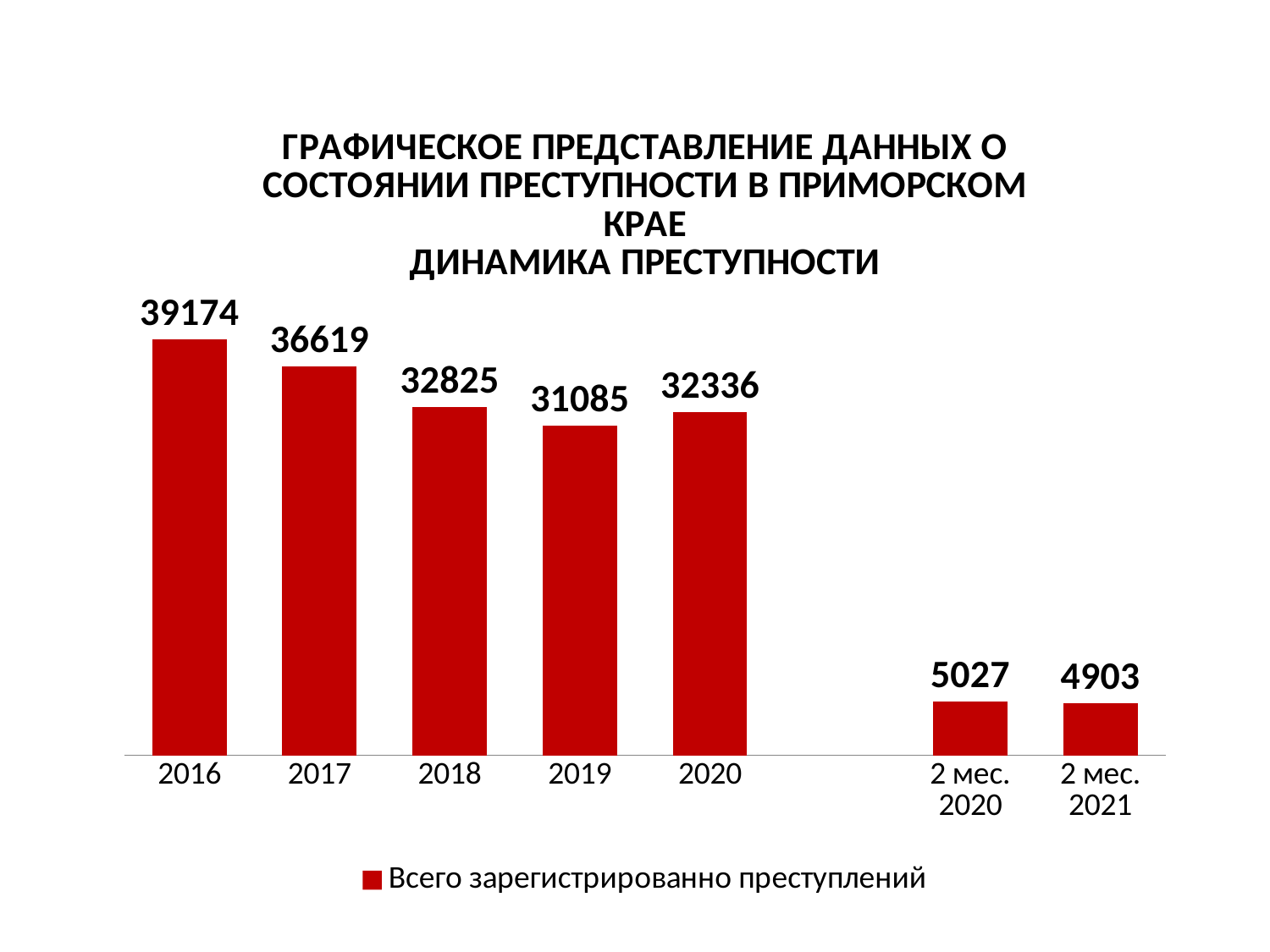
Do the values rise or fall from 2016 to 2019? fall What is the value for 2016? 39174 How many categories are shown on the x axis? 7 How many series does the legend list? 1 What is the difference between the values for 2 мес. 2020 and 2 мес. 2021? 124 Which category has the lowest value? 2 мес. 2021 What is the difference between the values for 2016 and 2017? 2555 What is the value for 2019? 31085 Which category has the highest value? 2016 What kind of chart is this? bar chart What is the value for 2 мес. 2021? 4903 Which is larger, the value for 2019 or the value for 2020? 2020